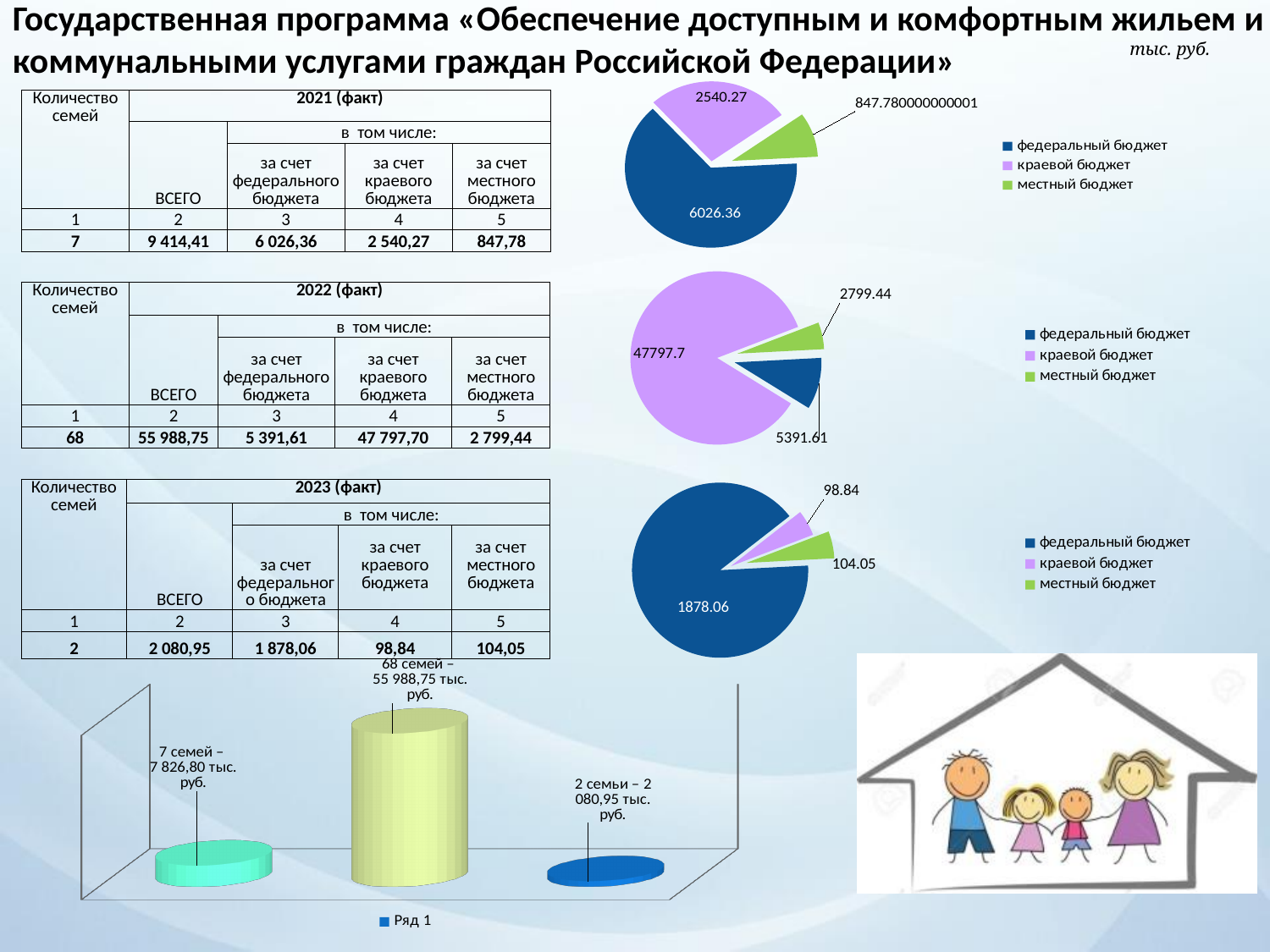
What kind of chart is shown at the bottom left of the slide? bar chart In the bottom pie chart, what is the difference between местный бюджет and краевой бюджет? 5.21 In the middle pie chart, what is the value for краевой бюджет? 47797.7 In the bottom-left bar chart, what is the label on the tallest bar? 68 семей – 55 988,75 тыс. руб. In the middle pie chart, which budget has the smallest slice? местный бюджет In the bottom pie chart, what is the value for федеральный бюджет? 1878.06 How many series does the legend of the top pie chart list? 3 In the middle pie chart, what is the value for местный бюджет? 2799.44 In the top pie chart, which budget has the largest slice? федеральный бюджет In the top pie chart, what is the value for краевой бюджет? 2540.27 In the bottom pie chart, which is larger, краевой бюджет or местный бюджет? местный бюджет In the top pie chart, what is the value for федеральный бюджет? 6026.36